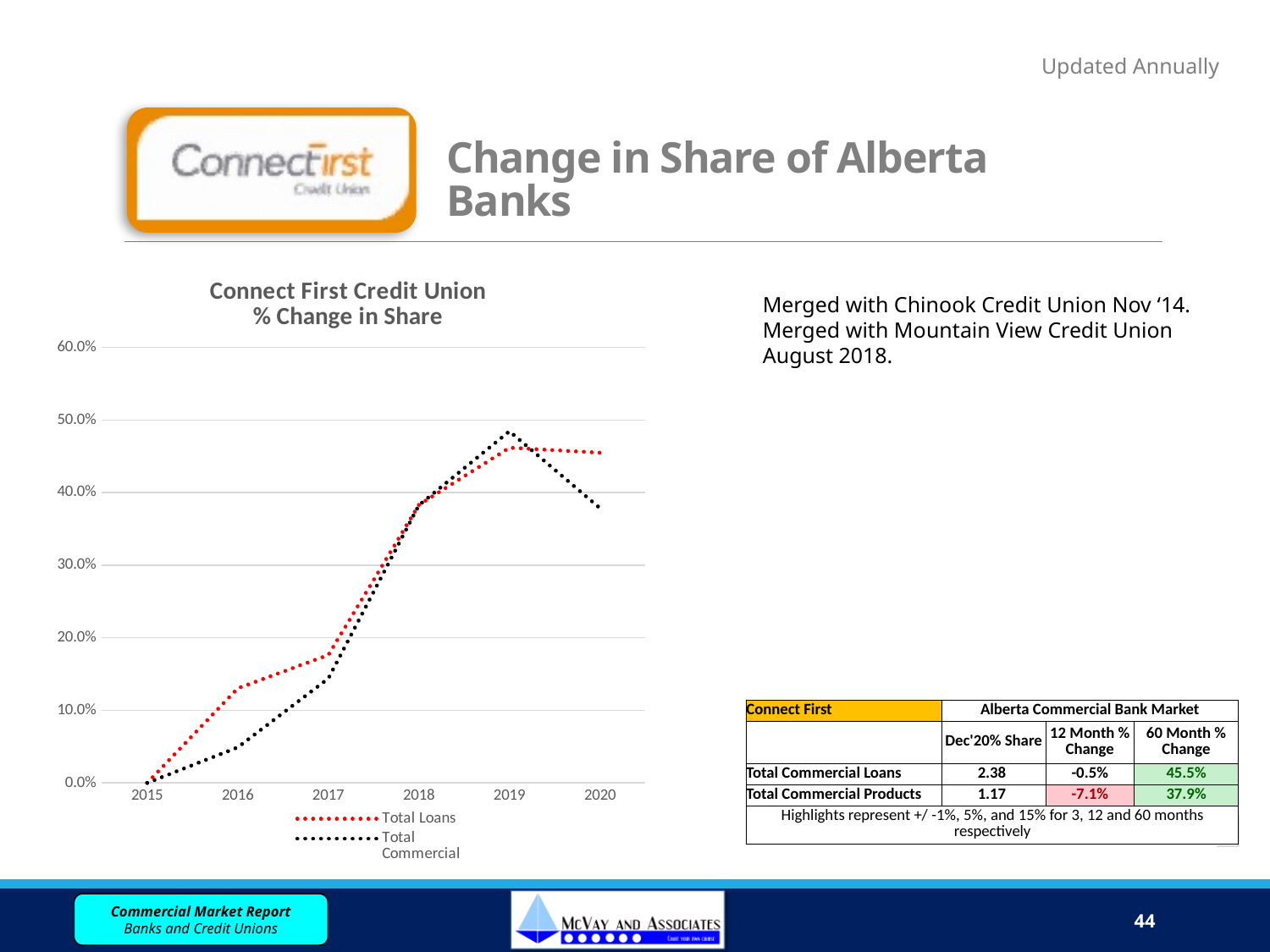
What kind of chart is the "Connect First Credit Union % Change in Share" chart? line chart In the "Connect First Credit Union % Change in Share" chart, is the Total Loans value for 2020 greater or less than 40.0%? greater In the "Connect First Credit Union % Change in Share" chart, is the Total Commercial value for 2020 greater or less than 40.0%? less In the "Connect First Credit Union % Change in Share" chart, which series has the higher value in 2020, Total Loans or Total Commercial? Total Loans In the "Connect First Credit Union % Change in Share" chart, is the Total Commercial value for 2016 greater or less than 10.0%? less In the "Connect First Credit Union % Change in Share" chart, which series has the higher value in 2016, Total Loans or Total Commercial? Total Loans How many series does the legend of the "Connect First Credit Union % Change in Share" chart list? 2 How many years are shown on the x axis of the "Connect First Credit Union % Change in Share" chart? 6 In the "Connect First Credit Union % Change in Share" chart, does the Total Commercial series rise or fall from 2019 to 2020? fall In the "Connect First Credit Union % Change in Share" chart, in which year does the Total Commercial series reach its highest value? 2019 In the "Connect First Credit Union % Change in Share" chart, what colour is the Total Loans line? red